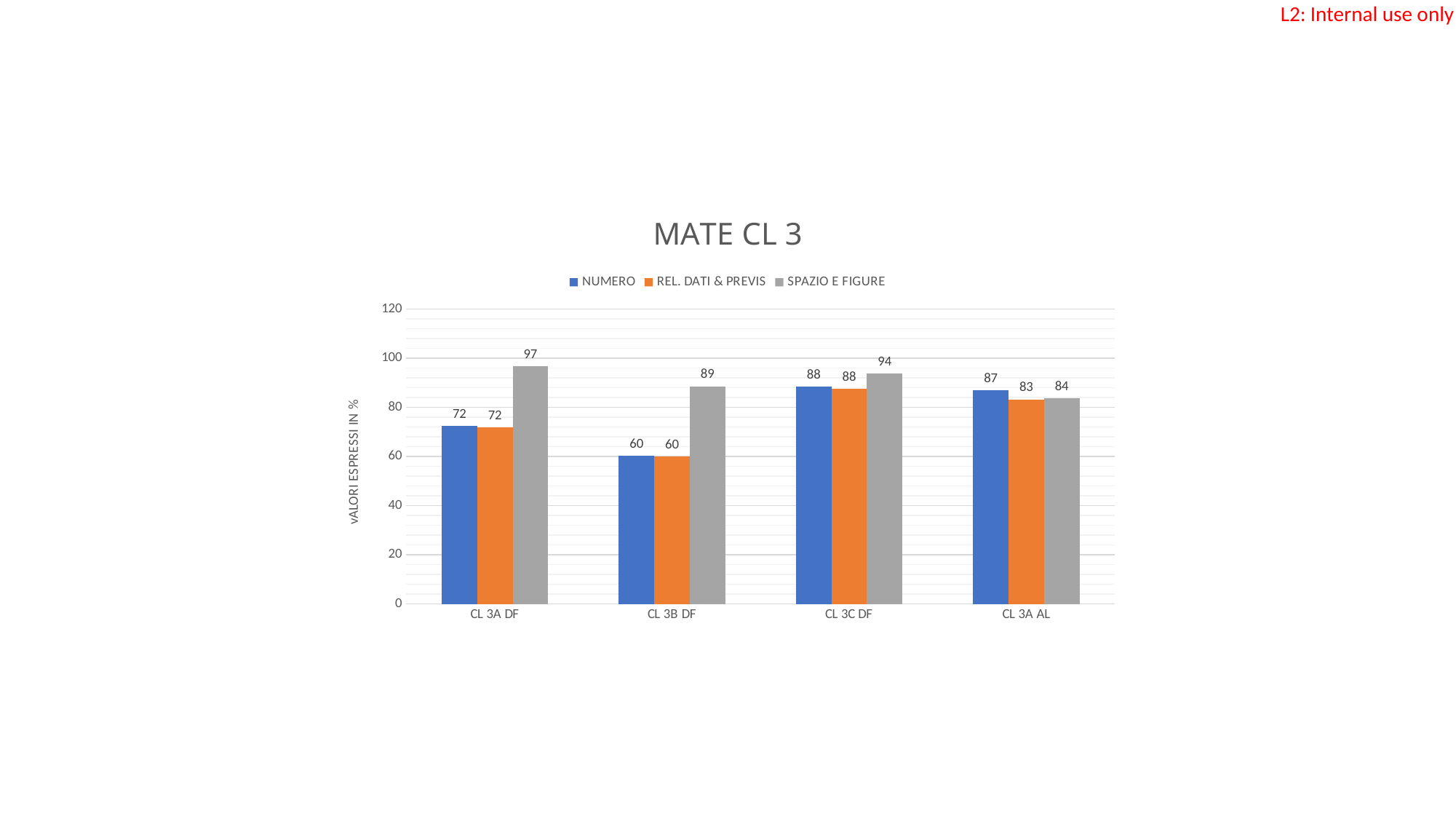
Is the SPAZIO E FIGURE value for CL 3C DF greater or less than 80? greater What is the title of the chart? MATE CL 3 What is the NUMERO value for CL 3B DF? 60 What is the SPAZIO E FIGURE value for CL 3A DF? 97 What is the REL. DATI & PREVIS value for CL 3A AL? 83 Which category has the highest SPAZIO E FIGURE value? CL 3A DF Which is larger for CL 3A AL: the NUMERO value or the SPAZIO E FIGURE value? NUMERO How many categories are shown on the x axis? 4 Which category has the lowest NUMERO value? CL 3B DF What is the difference between the SPAZIO E FIGURE and NUMERO values for CL 3B DF? 29 What kind of chart is shown? bar chart How many series does the legend list? 3